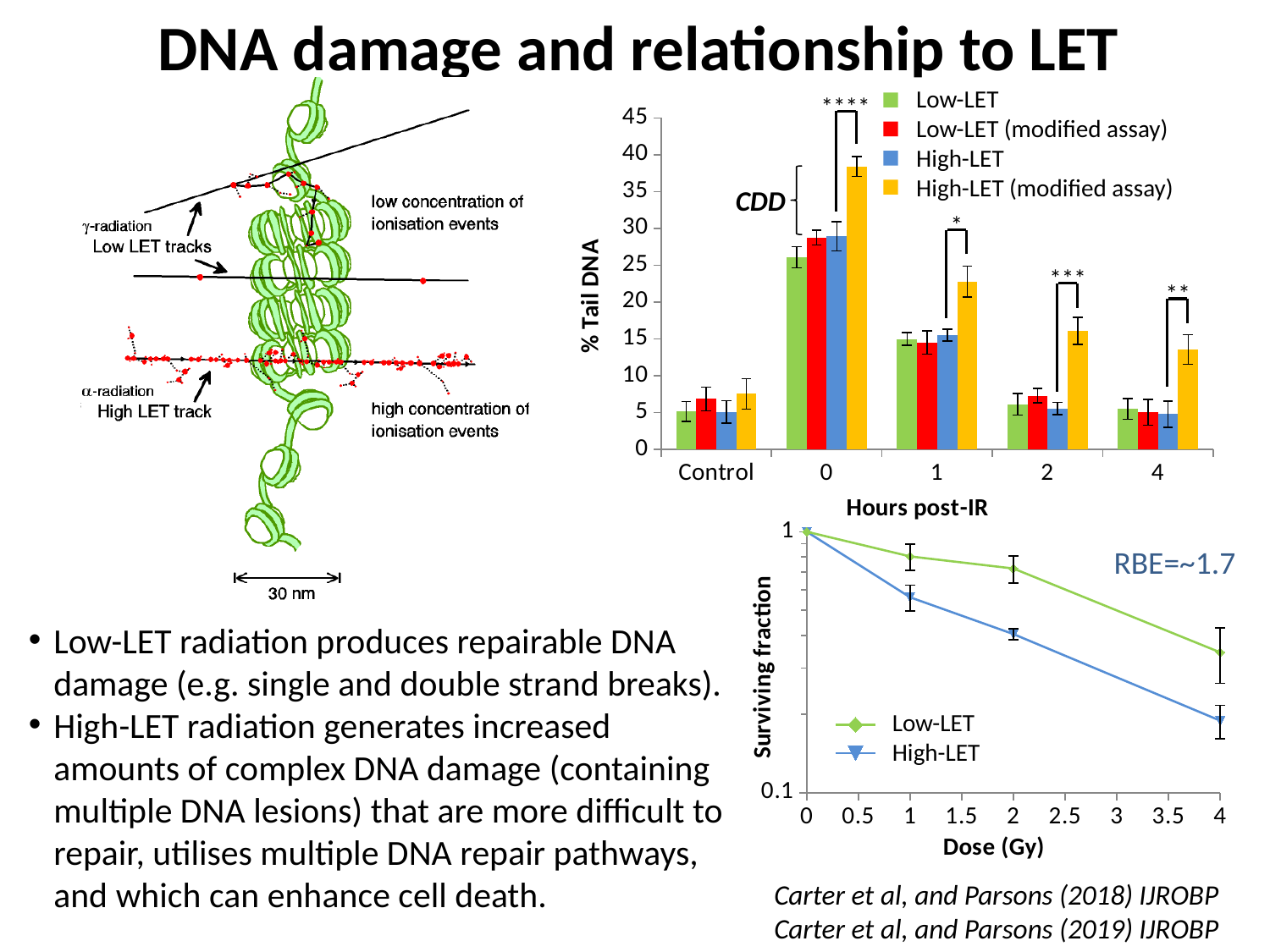
In the '% Tail DNA' bar chart, which is larger at 2 hours post-IR: High-LET or High-LET (modified assay)? High-LET (modified assay) In the '% Tail DNA' bar chart, is the value for High-LET (modified assay) at 1 hour post-IR greater or less than 20? greater In the 'Surviving fraction' line chart, do the values rise or fall as Dose (Gy) increases? fall In the 'Surviving fraction' line chart, how many series does the legend list? 2 In the '% Tail DNA' bar chart, how many categories are shown on the 'Hours post-IR' axis? 5 What type of chart is the chart titled with the y axis '% Tail DNA'? bar chart In the '% Tail DNA' bar chart, which series has the highest bar at 0 hours post-IR? High-LET (modified assay) In the '% Tail DNA' bar chart, how many series does the legend list? 4 In the 'Surviving fraction' line chart, which series has the higher value at 4 Gy: Low-LET or High-LET? Low-LET In the '% Tail DNA' bar chart, is the value for High-LET (modified assay) at 4 hours post-IR greater or less than 15? less In the '% Tail DNA' bar chart, what is the label of the x axis? Hours post-IR In the '% Tail DNA' bar chart, is the value for High-LET (modified assay) at 0 hours post-IR greater or less than 35? greater